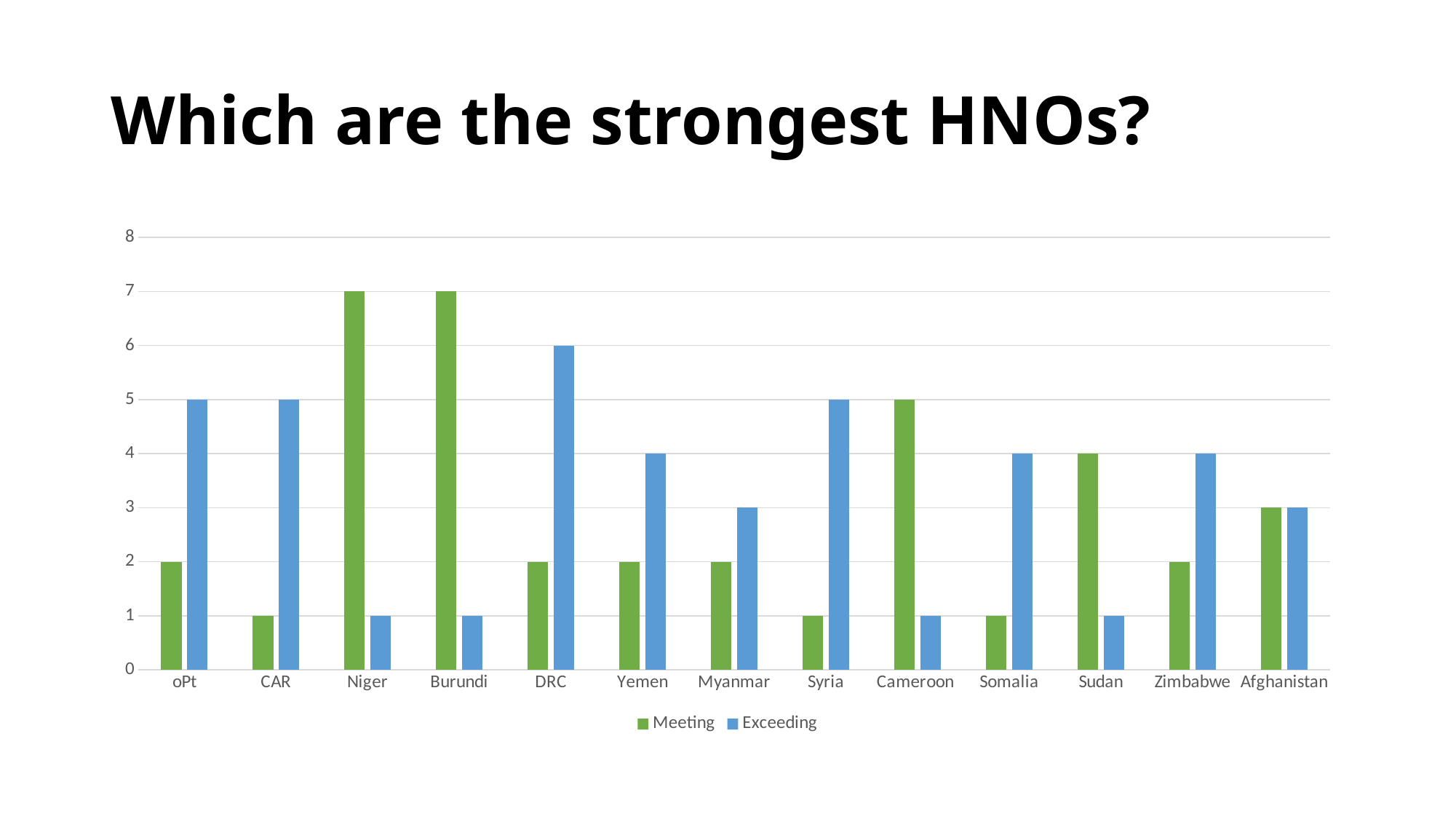
What kind of chart is shown on the slide? bar chart Which country has the highest Exceeding value? DRC What is the Exceeding value for Syria? 5 What is the Meeting value for Cameroon? 5 How many series does the legend list? 2 What is the Exceeding value for DRC? 6 How many countries are shown on the x axis? 13 What is the difference between the Exceeding and Meeting values for oPt? 3 Which is larger for Sudan, the Meeting value or the Exceeding value? Meeting What is the title of the slide? Which are the strongest HNOs? Is the Meeting value for Burundi greater or less than 5? greater What is the Meeting value for Niger? 7